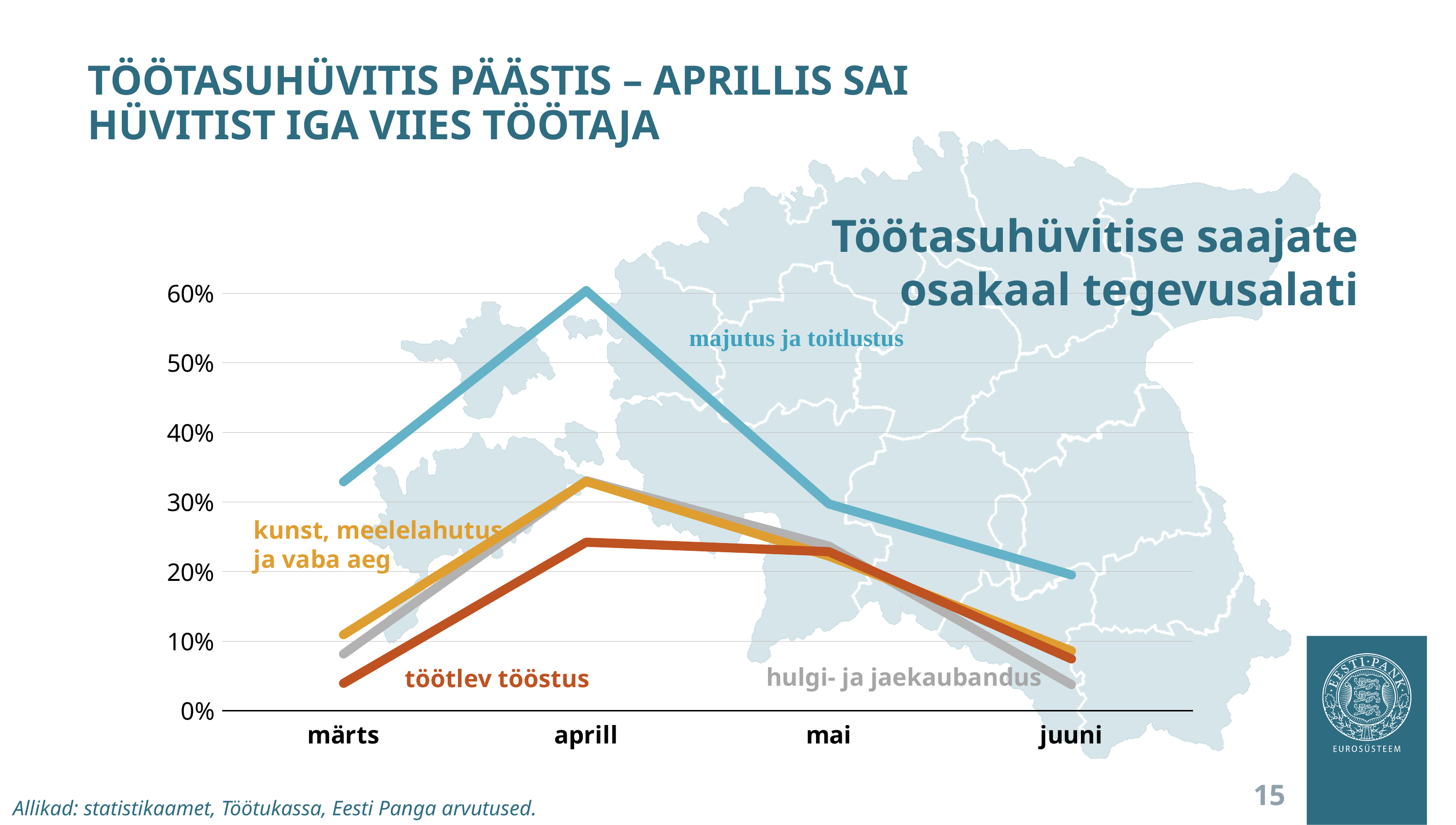
What kind of chart is shown on the slide? line chart Which is larger in aprill: majutus ja toitlustus or töötlev tööstus? majutus ja toitlustus Is the value for majutus ja toitlustus in juuni greater or less than 30%? less How many series (tegevusalad) are plotted on the chart? 4 Is the value for majutus ja toitlustus in aprill greater or less than 50%? greater In which month does majutus ja toitlustus reach its highest value? aprill Is the value for töötlev tööstus in märts greater or less than 10%? less Which series has the highest value in aprill? majutus ja toitlustus Which series has the lowest value in märts? töötlev tööstus What is the title of the chart? Töötasuhüvitise saajate osakaal tegevusalati How many months are shown on the x axis of the chart? 4 Does the value for majutus ja toitlustus rise or fall from aprill to juuni? fall